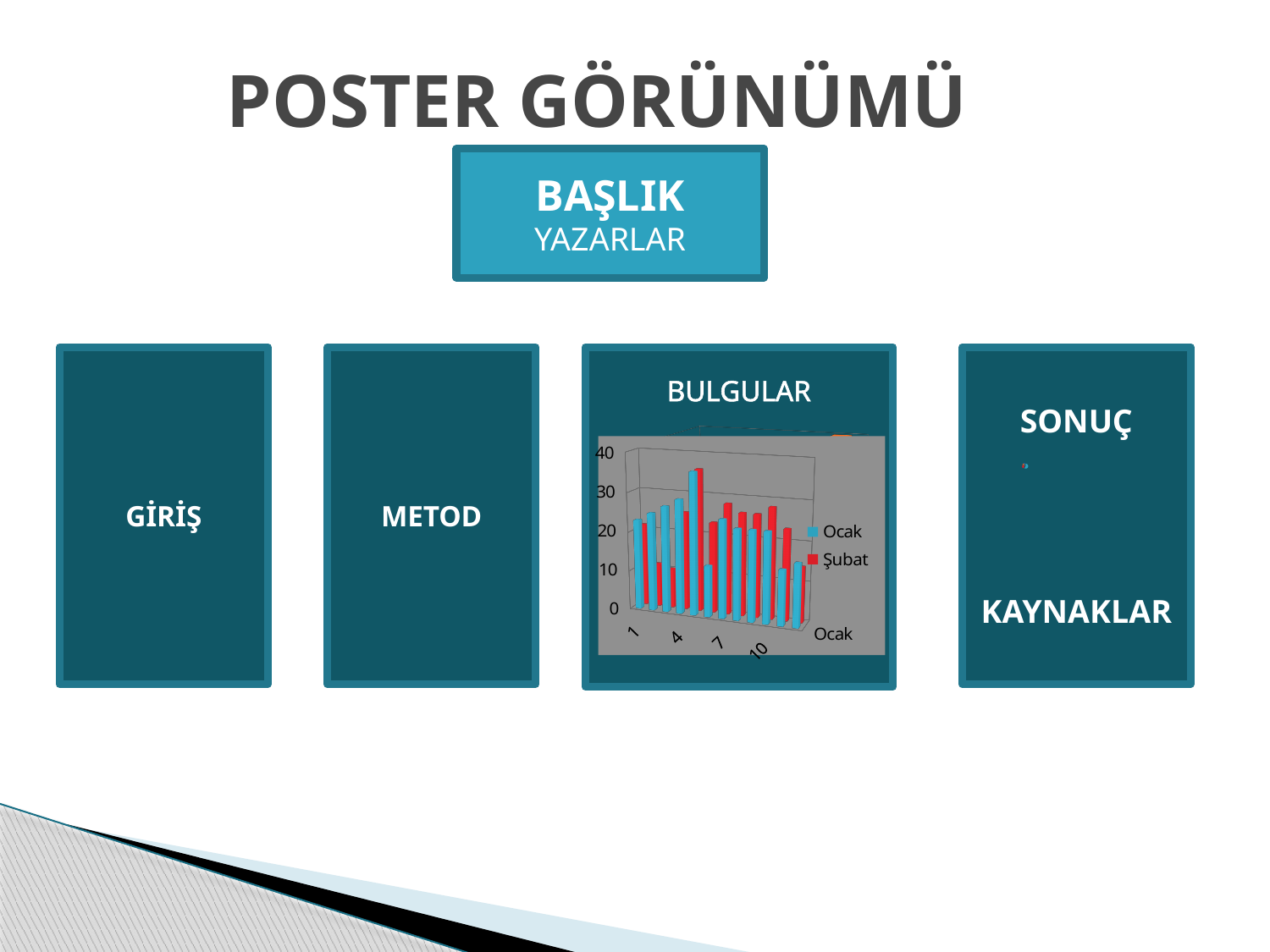
Which series in the BULGULAR chart is drawn in red? Şubat How many series does the legend of the BULGULAR chart list? 2 What kind of chart is shown in the BULGULAR panel? bar chart In the BULGULAR chart, is the Ocak value for category 1 greater or less than 10? greater In the BULGULAR chart, is the Ocak value for category 1 greater or less than 40? less What are the two series named in the legend of the BULGULAR chart? Ocak and Şubat In the BULGULAR chart, is the Şubat value for category 1 greater or less than 40? less